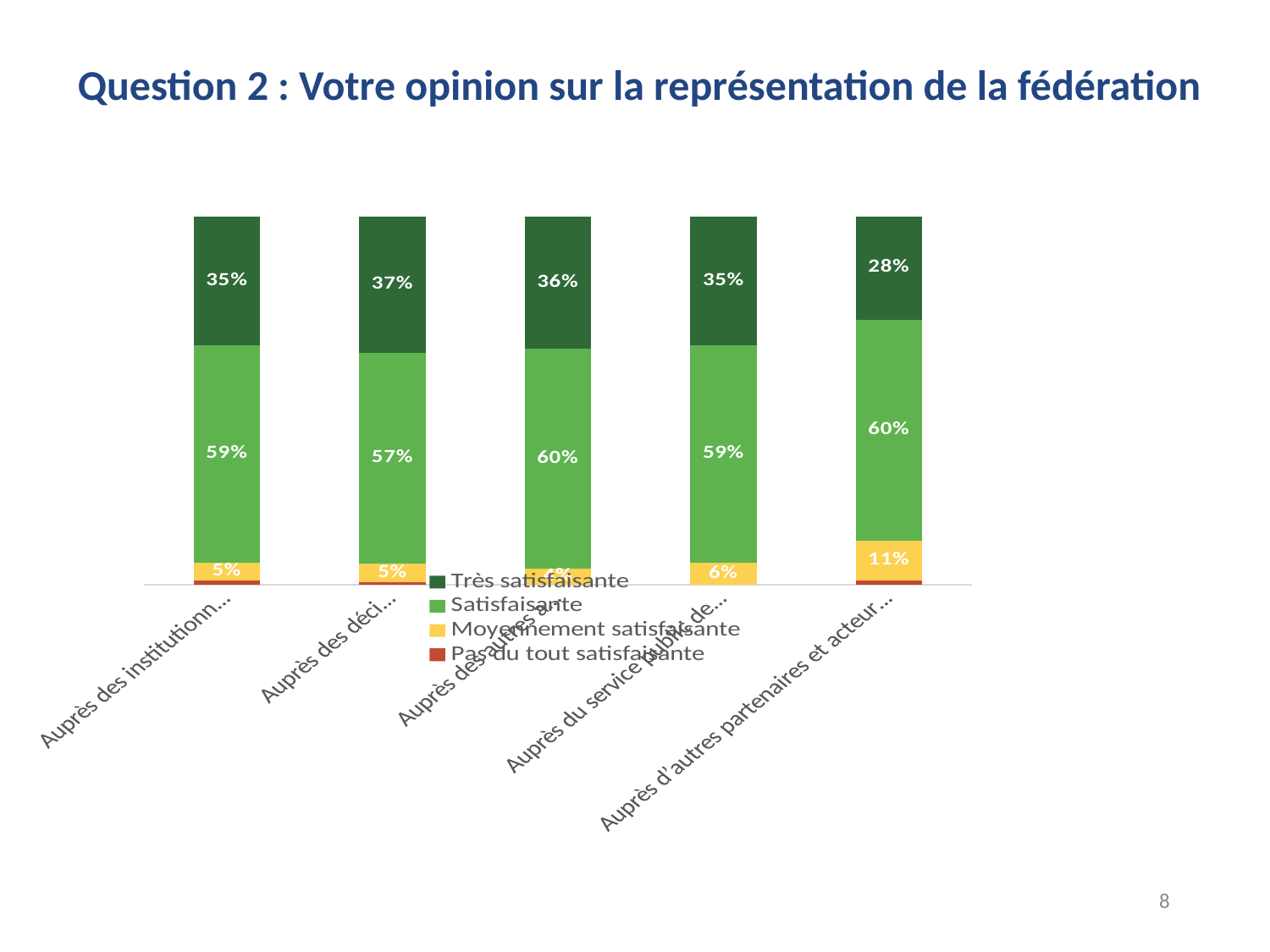
Which has the larger 'Satisfaisante' value: the first bar (Auprès des institutionn…) or the second bar (Auprès des déci…)? The first bar (Auprès des institutionn…) Which bar has the lowest 'Très satisfaisante' value? The fifth bar (Auprès d'autres partenaires et acteur…) What is the 'Moyennement satisfaisante' value for the fourth bar (Auprès du service public de…)? 6% How many bars (categories) are plotted in the chart? 5 What is the 'Très satisfaisante' value for the fifth bar (Auprès d'autres partenaires et acteur…)? 28% What is the difference between the 'Très satisfaisante' value of the second bar and that of the fifth bar? 9 percentage points What kind of chart is shown on the slide? Stacked bar chart What is the 'Moyennement satisfaisante' value for the fifth bar (Auprès d'autres partenaires et acteur…)? 11% Which colour represents 'Pas du tout satisfaisante' in the legend? Red Which bar has the highest 'Moyennement satisfaisante' value? The fifth bar (Auprès d'autres partenaires et acteur…) What is the 'Satisfaisante' value for the second bar (Auprès des déci…)? 57% How many series does the legend list? 4